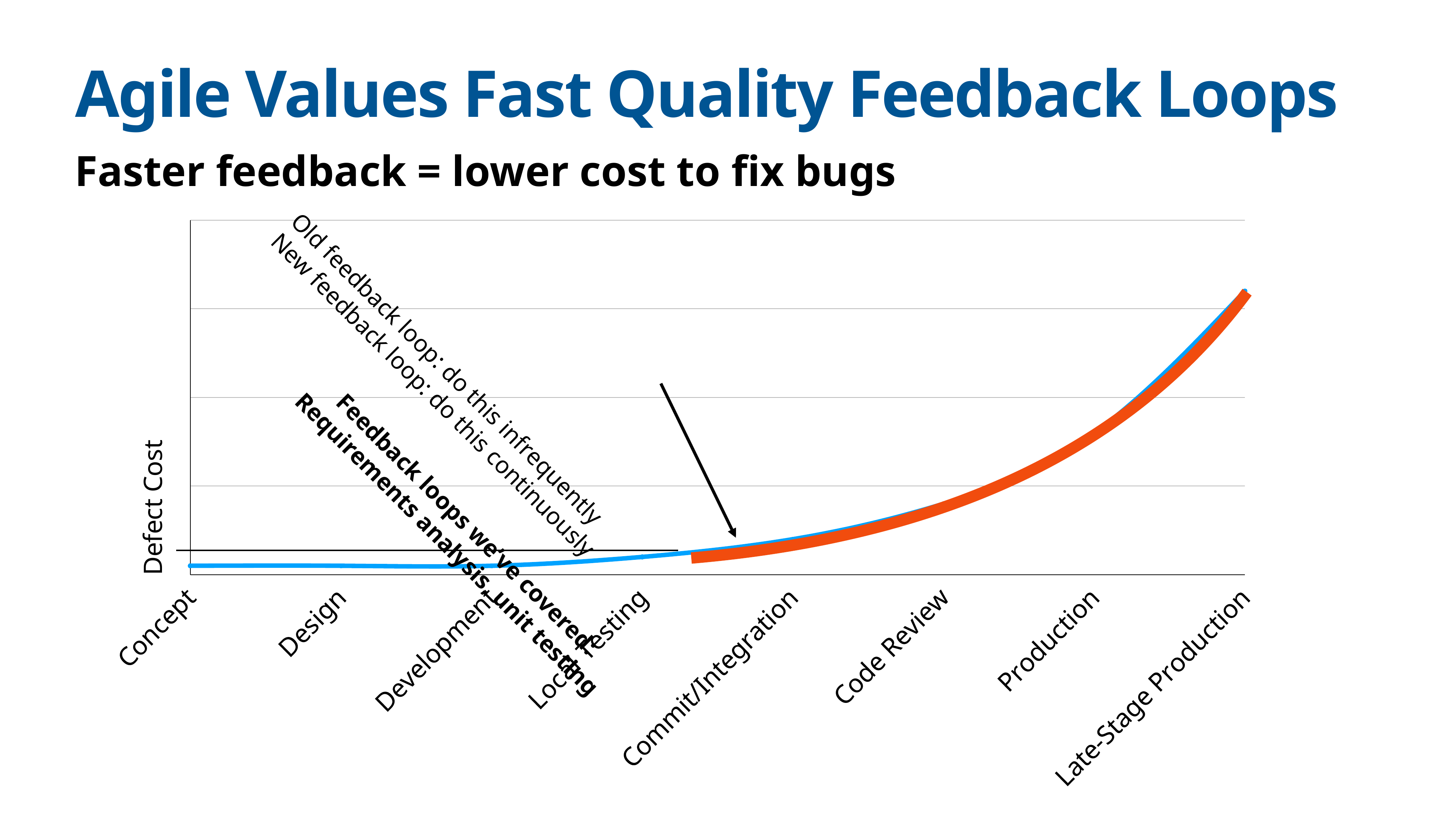
Does the Defect Cost rise or fall as you move from Concept to Late-Stage Production along the x axis? Rise Which has a higher Defect Cost, Commit/Integration or Late-Stage Production? Late-Stage Production Which has a higher Defect Cost, Code Review or Local Testing? Code Review What kind of chart is shown on the slide? Line chart What is the label on the vertical axis of the chart? Defect Cost Which has a higher Defect Cost, Production or Code Review? Production Which category has the highest Defect Cost in the chart? Late-Stage Production How many categories are shown along the x axis of the chart? 8 What is the first category on the x axis of the chart? Concept